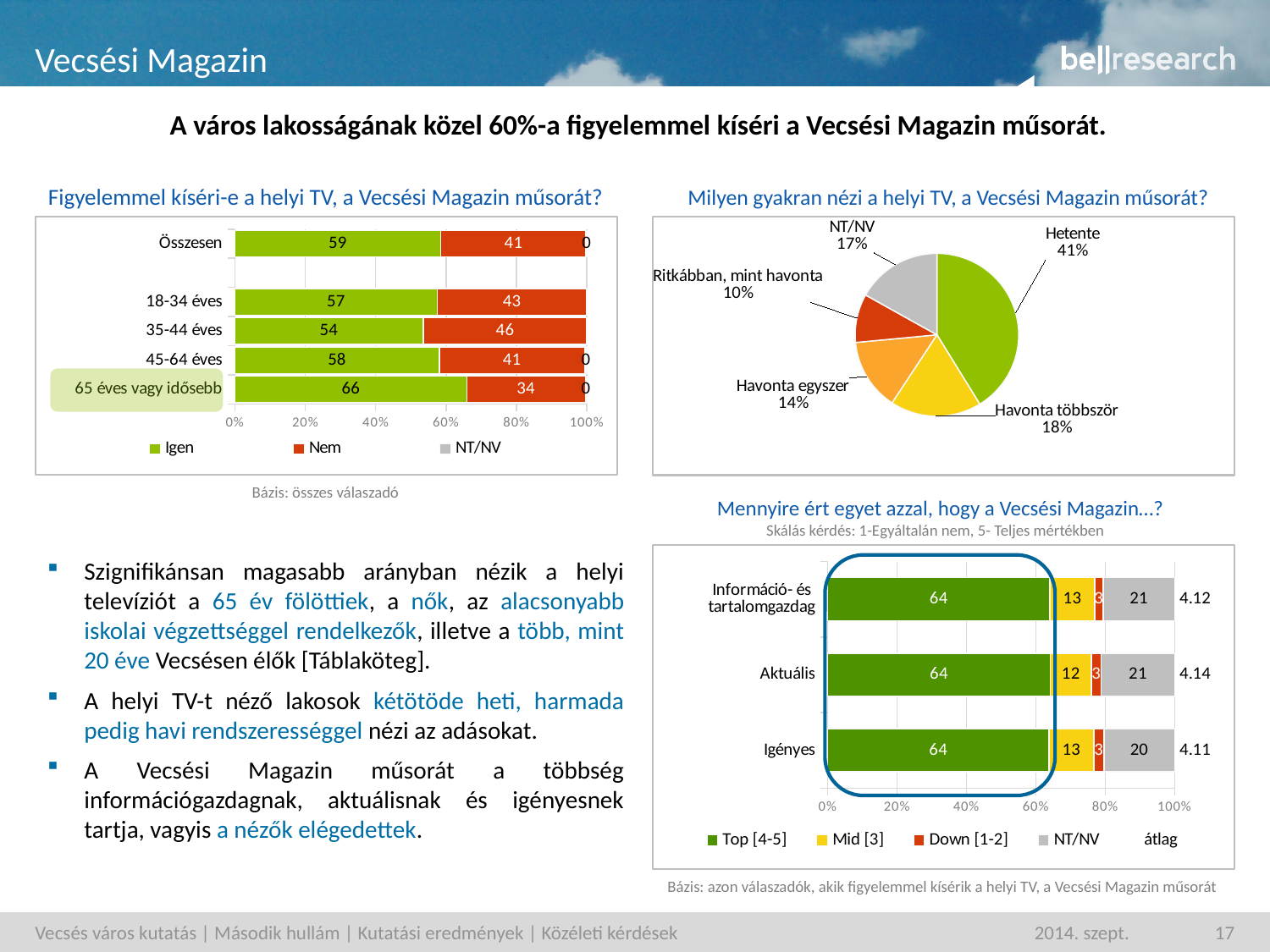
In the chart 'Figyelemmel kíséri-e a helyi TV, a Vecsési Magazin műsorát?', which age group has the highest 'Igen' value? 65 éves vagy idősebb In the pie chart 'Milyen gyakran nézi a helyi TV, a Vecsési Magazin műsorát?', which slice is the smallest? Ritkábban, mint havonta In the chart 'Mennyire ért egyet azzal, hogy a Vecsési Magazin…?', which category has the highest 'átlag' value? Aktuális In the chart 'Figyelemmel kíséri-e a helyi TV, a Vecsési Magazin műsorát?', what is the difference between the 'Igen' values for '65 éves vagy idősebb' and '35-44 éves'? 12 In the chart 'Mennyire ért egyet azzal, hogy a Vecsési Magazin…?', what is the 'NT/NV' value for 'Igényes'? 20 In the chart 'Figyelemmel kíséri-e a helyi TV, a Vecsési Magazin műsorát?', what is the 'Igen' value for '65 éves vagy idősebb'? 66 In the chart 'Mennyire ért egyet azzal, hogy a Vecsési Magazin…?', what is the 'átlag' value for 'Aktuális'? 4.14 What type of chart is 'Milyen gyakran nézi a helyi TV, a Vecsési Magazin műsorát?'? pie chart In the chart 'Figyelemmel kíséri-e a helyi TV, a Vecsési Magazin műsorát?', what is the 'Nem' value for '35-44 éves'? 46 In the pie chart 'Milyen gyakran nézi a helyi TV, a Vecsési Magazin műsorát?', how many slices are there? 5 In the chart 'Figyelemmel kíséri-e a helyi TV, a Vecsési Magazin műsorát?', how many series does the legend list? 3 In the pie chart 'Milyen gyakran nézi a helyi TV, a Vecsési Magazin műsorát?', what share does 'Hetente' have? 41%